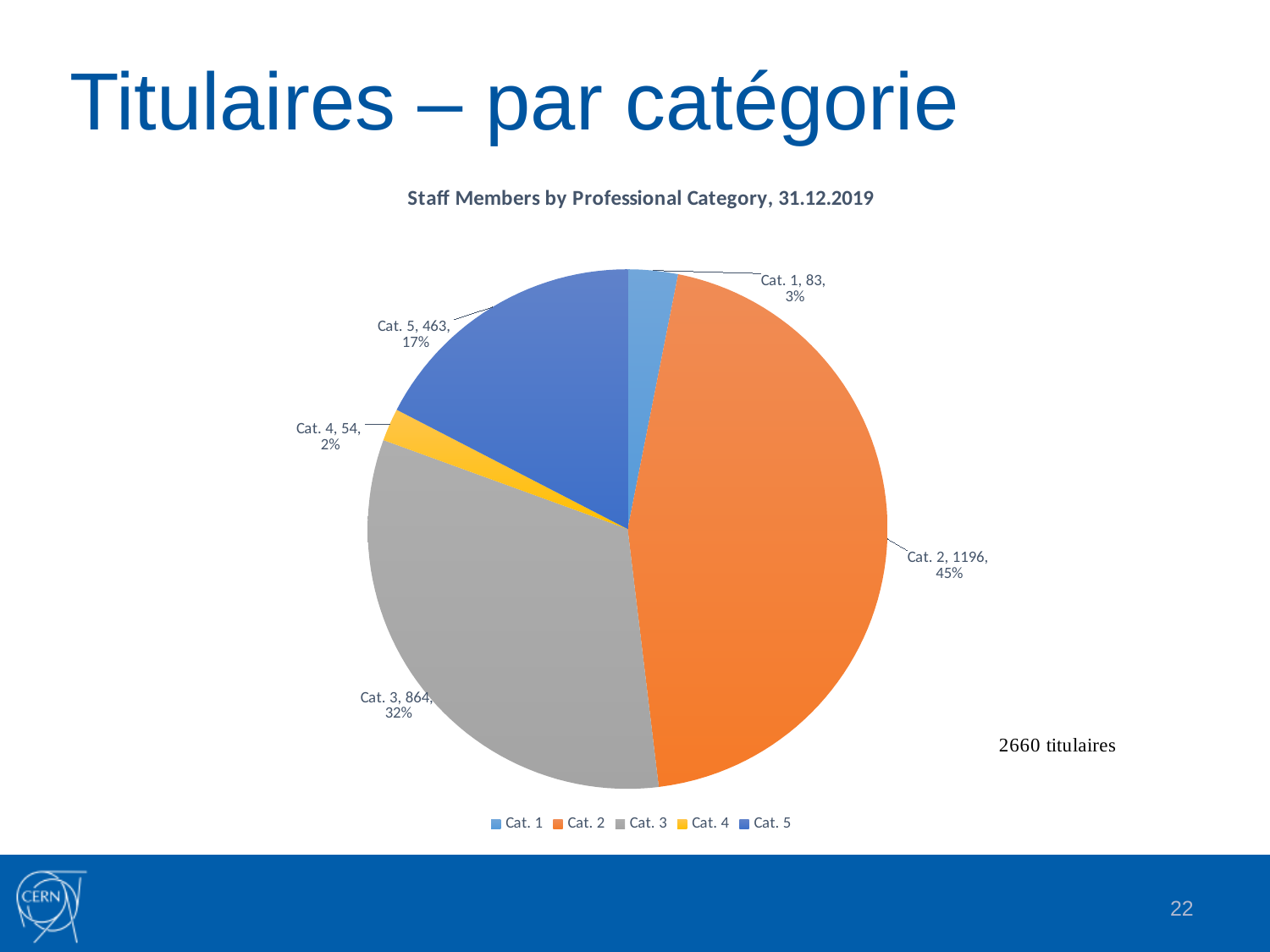
What share of the pie does Cat. 3 represent? 32% How many staff members are in Cat. 5? 463 How many categories are shown in the pie chart? 5 Which category has the largest number of staff members? Cat. 2 What is the difference in staff members between Cat. 2 and Cat. 3? 332 Which category has the smallest number of staff members? Cat. 4 What is the title of the chart? Staff Members by Professional Category, 31.12.2019 What type of chart is shown on the slide? pie chart What is the total number of staff members shown on the slide? 2660 How many staff members are in Cat. 2? 1196 What share of the pie does Cat. 4 represent? 2% Which has more staff members, Cat. 1 or Cat. 5? Cat. 5